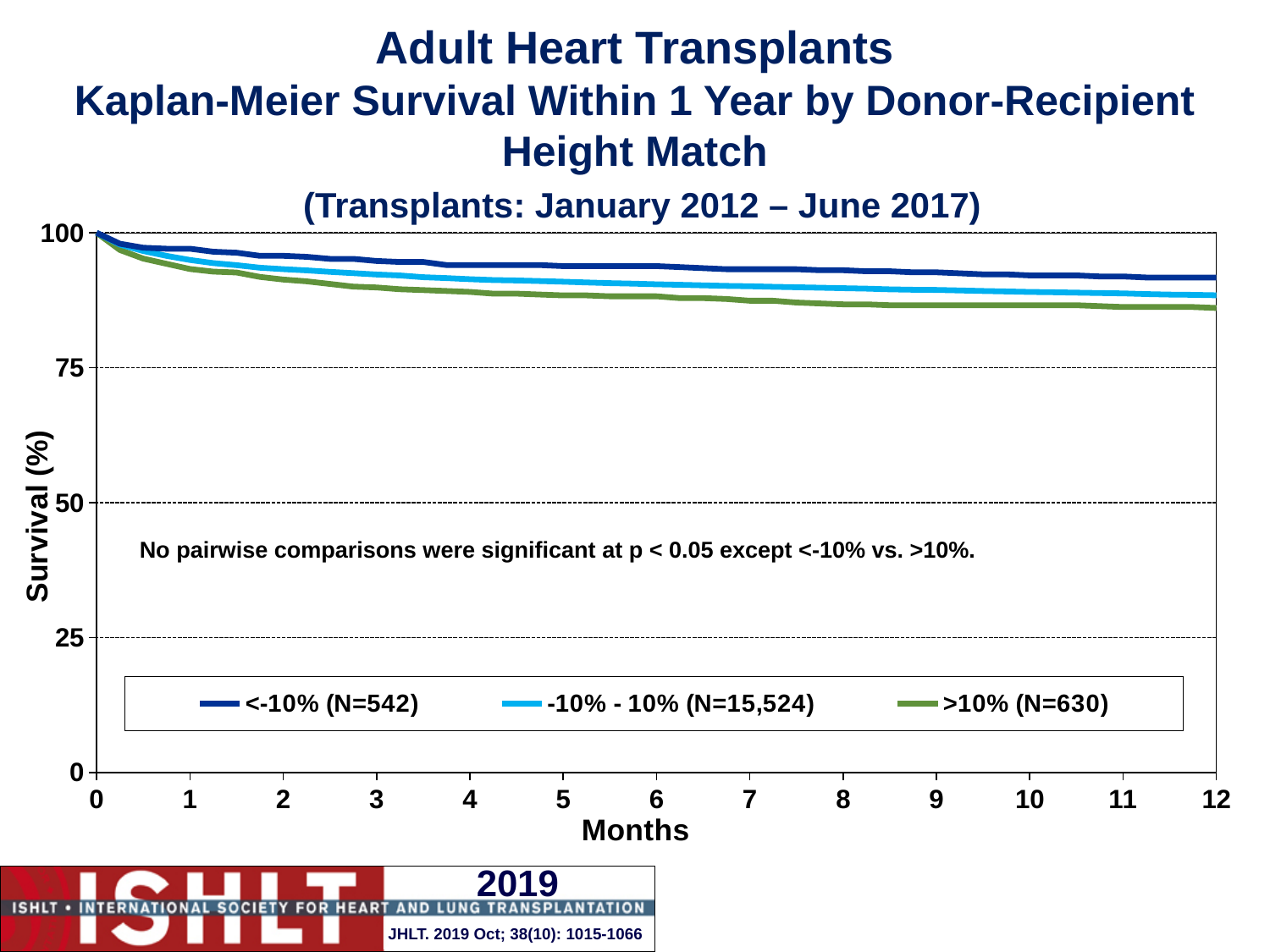
Is the survival value for the >10% group at 12 months greater or less than 75? greater How many series does the legend list? 3 Is the survival value for the -10% - 10% group at 6 months greater or less than 75? greater Which height-match group has the highest survival at 12 months? <-10% (N=542) Do the survival curves rise or fall as months increase? fall How many month tick marks are shown on the x axis from 0 to 12? 13 At 12 months, is survival higher for the <-10% group or the >10% group? <-10% group Which height-match group has the lowest survival at 12 months? >10% (N=630) What is the label of the x axis? Months What is the N for the -10% - 10% group shown in the legend? N=15,524 What kind of chart is shown on the slide? line chart